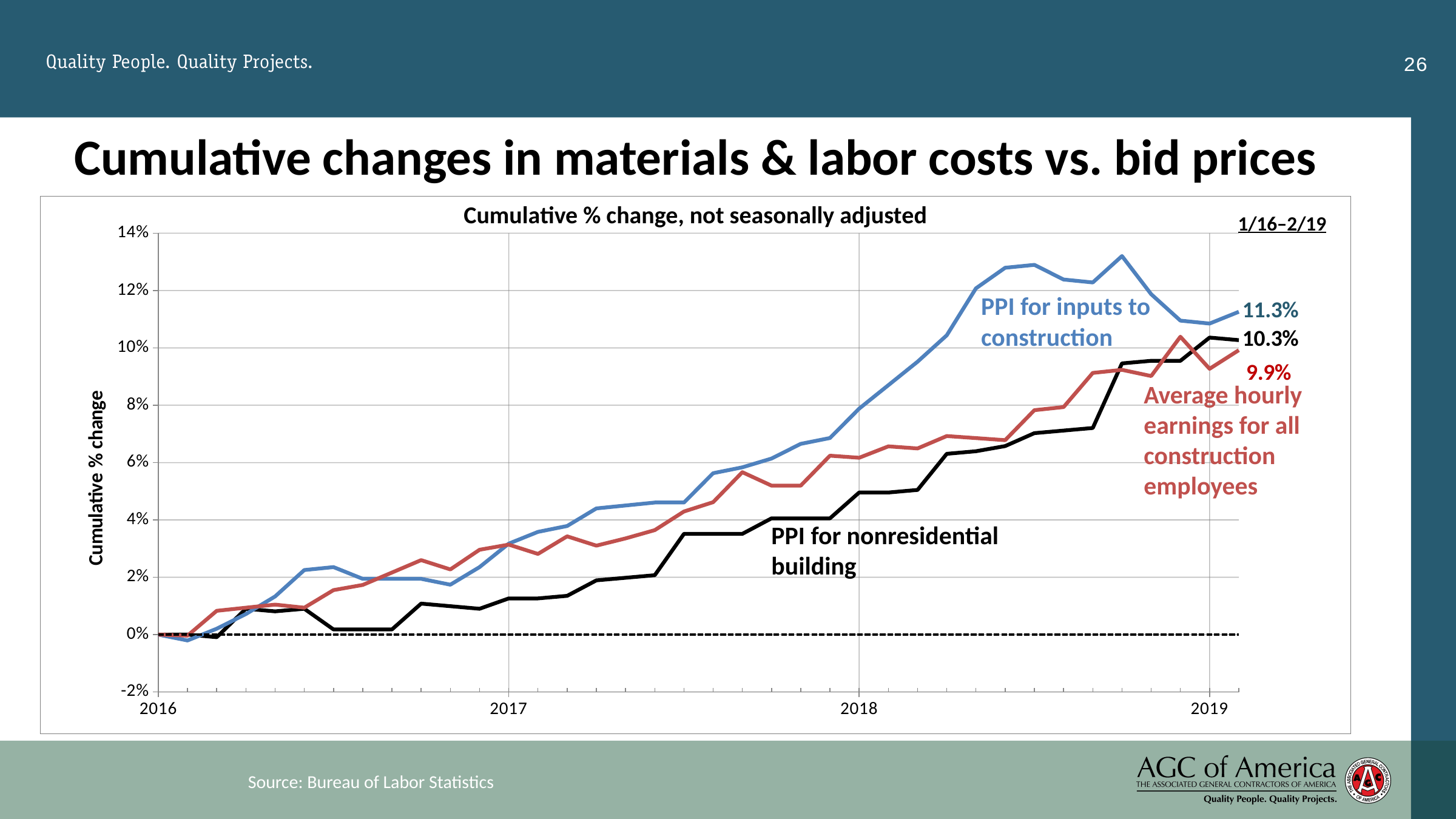
What is the difference between the final values for PPI for nonresidential building and average hourly earnings for all construction employees? 0.4% Which series has the highest final cumulative % change? PPI for inputs to construction How many series are plotted on the chart? 3 What is the final cumulative % change for PPI for inputs to construction? 11.3% What is the difference between the final values for PPI for inputs to construction and PPI for nonresidential building? 1.0% What kind of chart is shown on the slide? line chart What is the final cumulative % change for average hourly earnings for all construction employees? 9.9% Is the peak value of PPI for inputs to construction greater or less than 12%? greater Which series has the lowest final cumulative % change? Average hourly earnings for all construction employees What period does the chart cover, as labeled in the top right corner? 1/16–2/19 Which is larger at the end of the period: PPI for inputs to construction or average hourly earnings for all construction employees? PPI for inputs to construction What is the final cumulative % change for PPI for nonresidential building? 10.3%